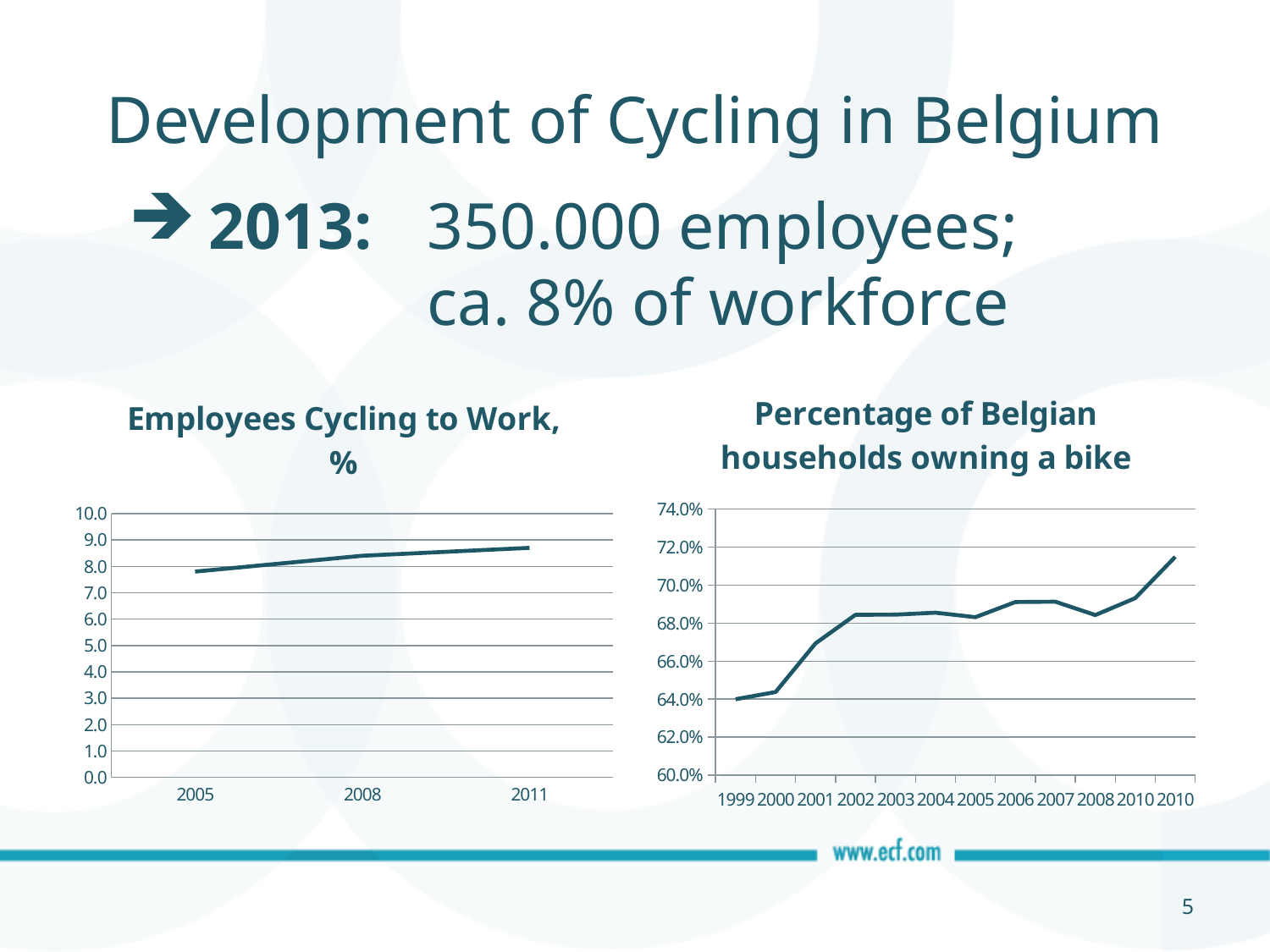
In the 'Employees Cycling to Work, %' chart, is the value for 2005 greater or less than 7.0? greater What kind of chart is the 'Percentage of Belgian households owning a bike' chart? line chart In the 'Employees Cycling to Work, %' chart, do the values rise or fall from 2005 to 2011? rise How many charts are on the slide? 2 In the 'Employees Cycling to Work, %' chart, is the value for 2011 greater or less than 9.0? less In the 'Employees Cycling to Work, %' chart, which year has the highest value? 2011 How many years are shown on the x axis of the 'Employees Cycling to Work, %' chart? 3 In the 'Percentage of Belgian households owning a bike' chart, is the value for 1999 greater or less than 66.0%? less In the 'Percentage of Belgian households owning a bike' chart, which is larger, the value for 2001 or the value for 2002? 2002 In the 'Percentage of Belgian households owning a bike' chart, which year has the lowest value? 1999 What kind of chart is the 'Employees Cycling to Work, %' chart? line chart